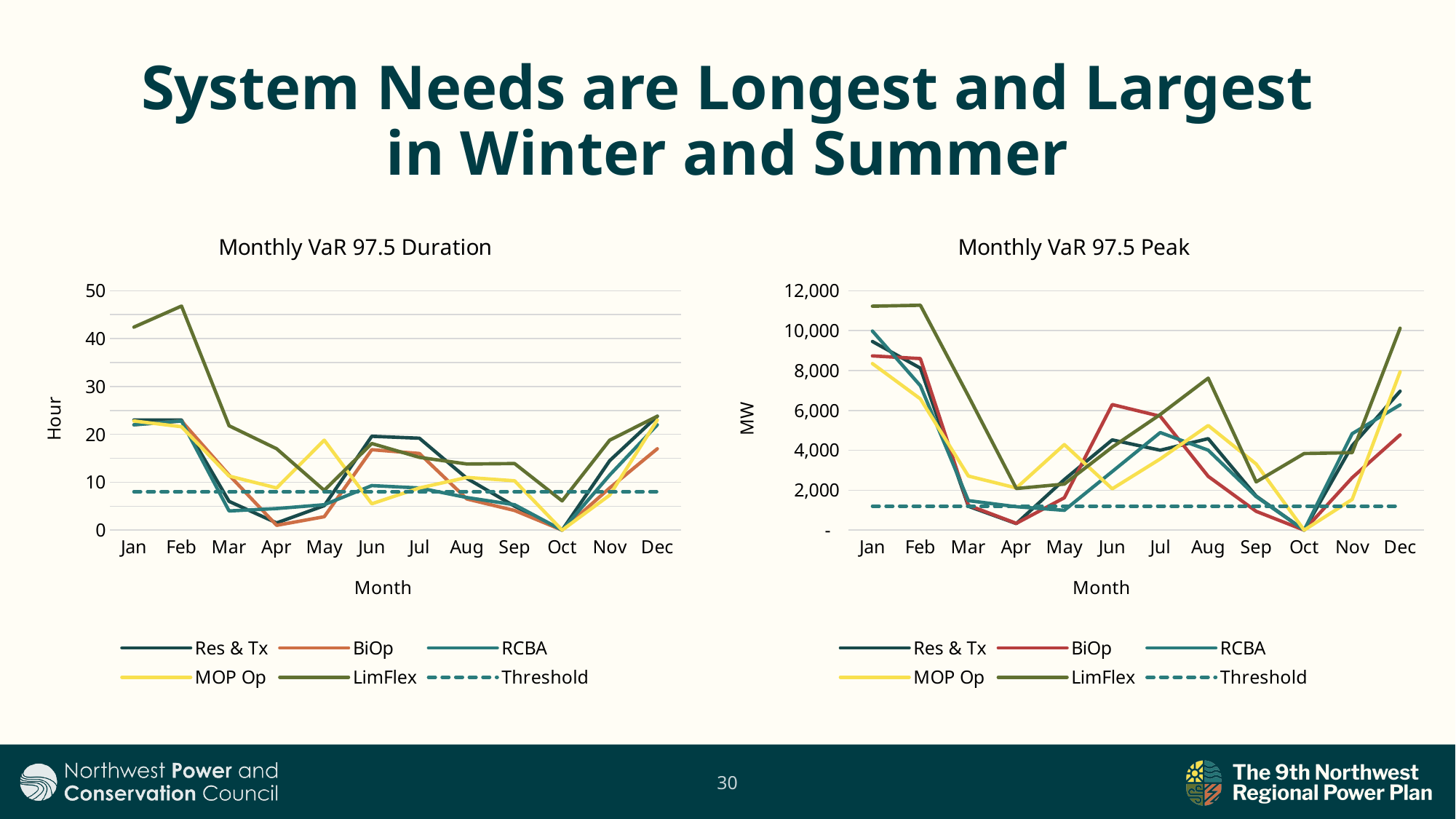
What is the y-axis label of the 'Monthly VaR 97.5 Peak' chart? MW In the 'Monthly VaR 97.5 Peak' chart, is the LimFlex value for Jan greater or less than 10,000? greater In the 'Monthly VaR 97.5 Peak' chart, is the Threshold line greater or less than 2,000 MW? less What kind of chart is the 'Monthly VaR 97.5 Duration' chart? line chart In the 'Monthly VaR 97.5 Peak' chart, does the LimFlex series rise or fall from Feb to Apr? fall In the 'Monthly VaR 97.5 Duration' chart, is the MOP Op value larger in Apr or in May? May How many months are shown on the x axis of the 'Monthly VaR 97.5 Peak' chart? 12 In the 'Monthly VaR 97.5 Peak' chart, which series has the highest value in Jan? LimFlex In the 'Monthly VaR 97.5 Duration' chart, which series has the highest value in Feb? LimFlex In the 'Monthly VaR 97.5 Duration' chart, in which month does the LimFlex series reach its highest value? Feb In the 'Monthly VaR 97.5 Duration' chart, is the LimFlex value for Feb greater or less than 40? greater How many entries does the legend of the 'Monthly VaR 97.5 Duration' chart list? 6